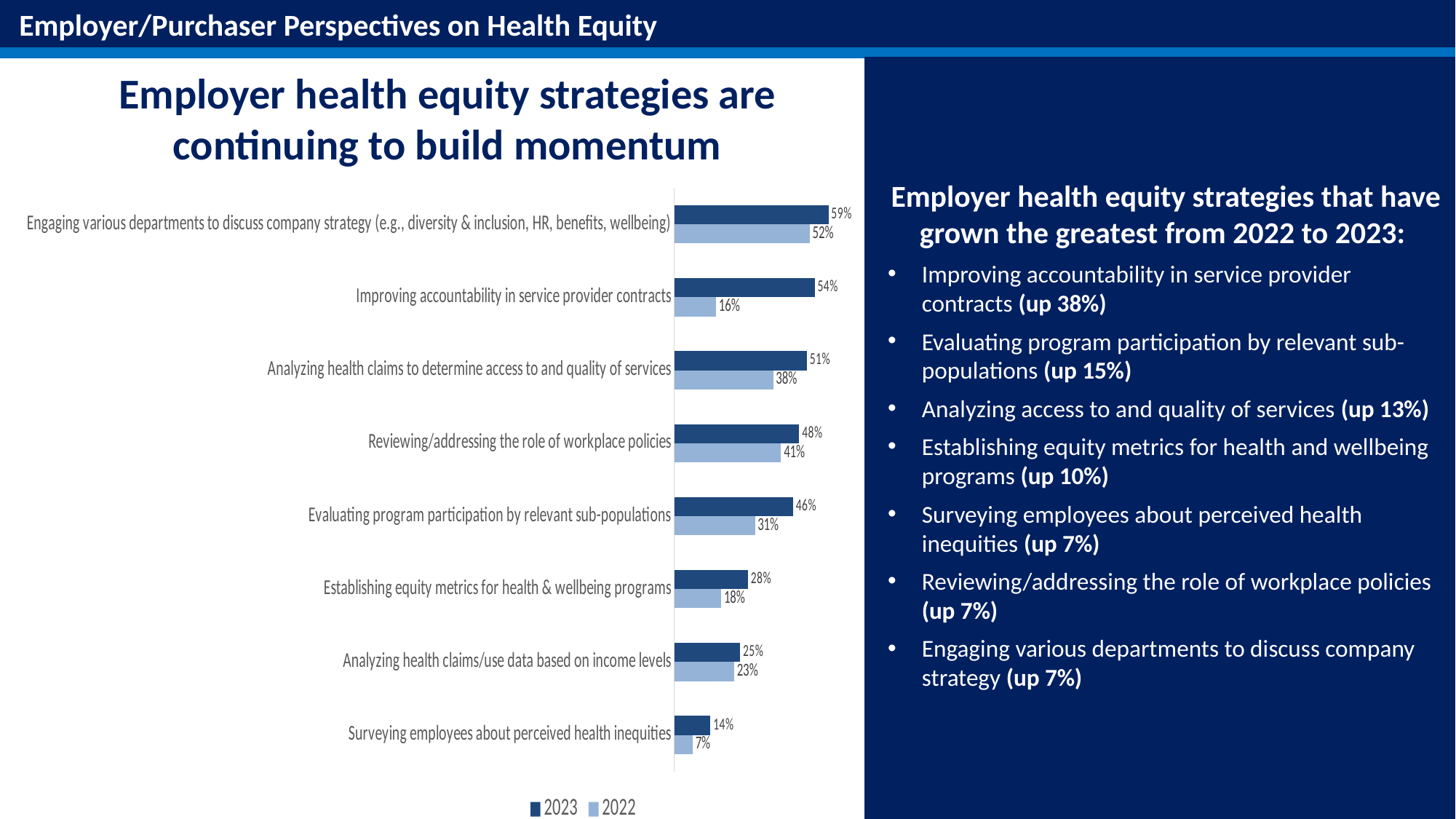
Which category has the lowest 2022 value? Surveying employees about perceived health inequities How many categories are shown in the bar chart? 8 What is the difference between the 2023 and 2022 values for 'Evaluating program participation by relevant sub-populations'? 15% What is the difference between the 2023 and 2022 values for 'Improving accountability in service provider contracts'? 38% Which category has the highest 2023 value? Engaging various departments to discuss company strategy (e.g., diversity & inclusion, HR, benefits, wellbeing) What kind of chart is shown on the slide? Bar chart Which is larger: the 2022 value for 'Reviewing/addressing the role of workplace policies' or the 2022 value for 'Evaluating program participation by relevant sub-populations'? Reviewing/addressing the role of workplace policies What is the 2022 value for 'Surveying employees about perceived health inequities'? 7% How many series does the legend list? 2 What is the 2022 value for 'Analyzing health claims to determine access to and quality of services'? 38% Which series is shown in the darker blue colour in the chart? 2023 What is the 2023 value for 'Improving accountability in service provider contracts'? 54%